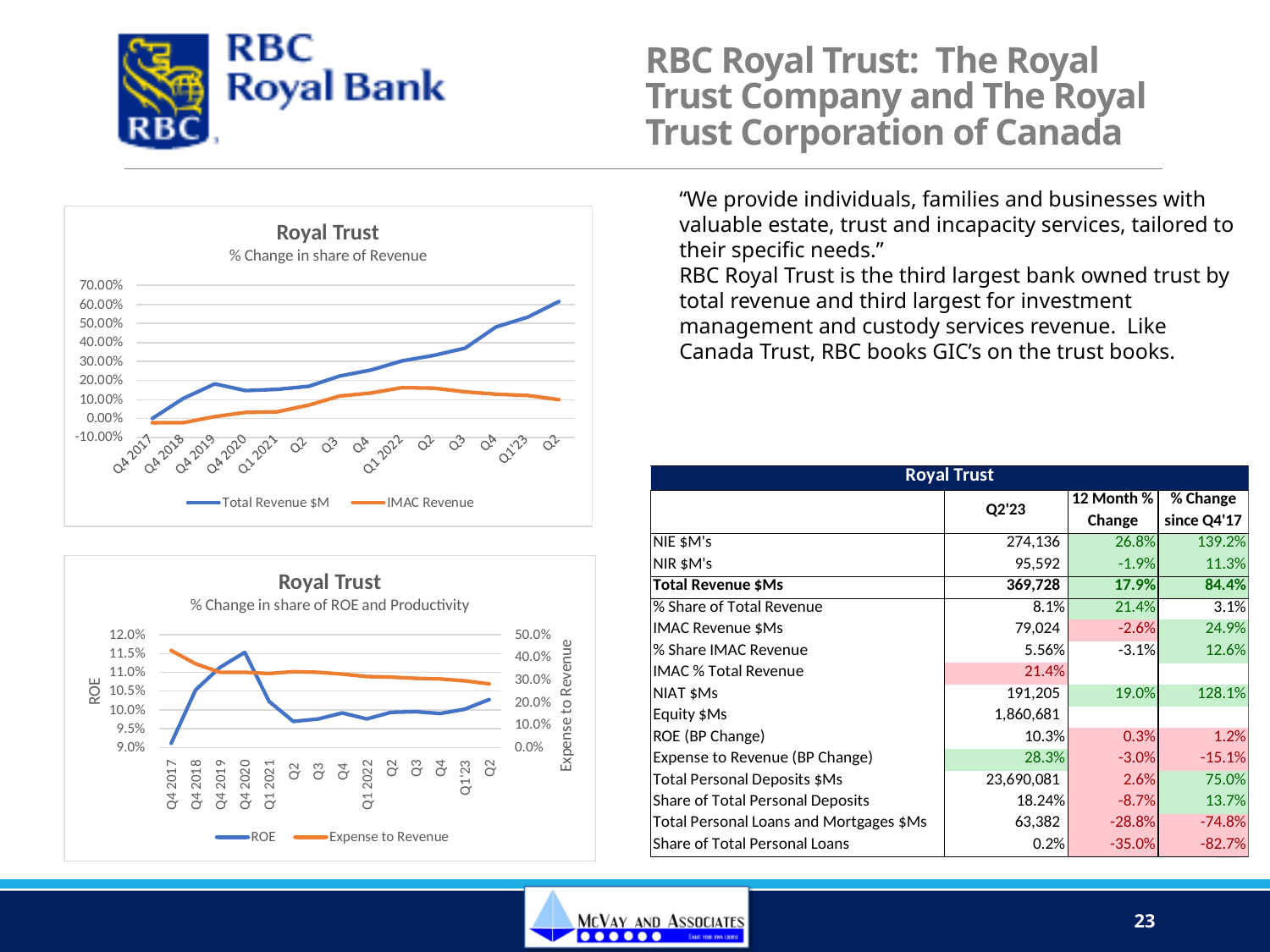
In the top chart (% Change in share of Revenue), how many quarters are plotted along the x axis? 14 In the top chart (% Change in share of Revenue), how many series does the legend list? 2 In the bottom chart (% Change in share of ROE and Productivity), is the value for Expense to Revenue at Q4 2017 greater or less than 30.0%? greater In the bottom chart (% Change in share of ROE and Productivity), what is the title of the right-hand vertical axis? Expense to Revenue What type of chart is the top chart titled 'Royal Trust % Change in share of Revenue'? Line chart In the bottom chart (% Change in share of ROE and Productivity), at which quarter does the ROE line reach its highest value? Q4 2020 In the top chart (% Change in share of Revenue), does the Total Revenue $M line generally rise or fall from Q4 2017 to the final Q2? Rise What type of chart is the bottom chart titled 'Royal Trust % Change in share of ROE and Productivity'? Line chart In the top chart (% Change in share of Revenue), is the value for IMAC Revenue at Q4 2017 greater or less than 10.00%? less In the top chart (% Change in share of Revenue), is the value for Total Revenue $M at the final point (Q2) greater or less than 50.00%? greater In the bottom chart (% Change in share of ROE and Productivity), at which quarter is the ROE line at its lowest value? Q4 2017 In the top chart (% Change in share of Revenue), which series is higher at the final point (Q2): Total Revenue $M or IMAC Revenue? Total Revenue $M